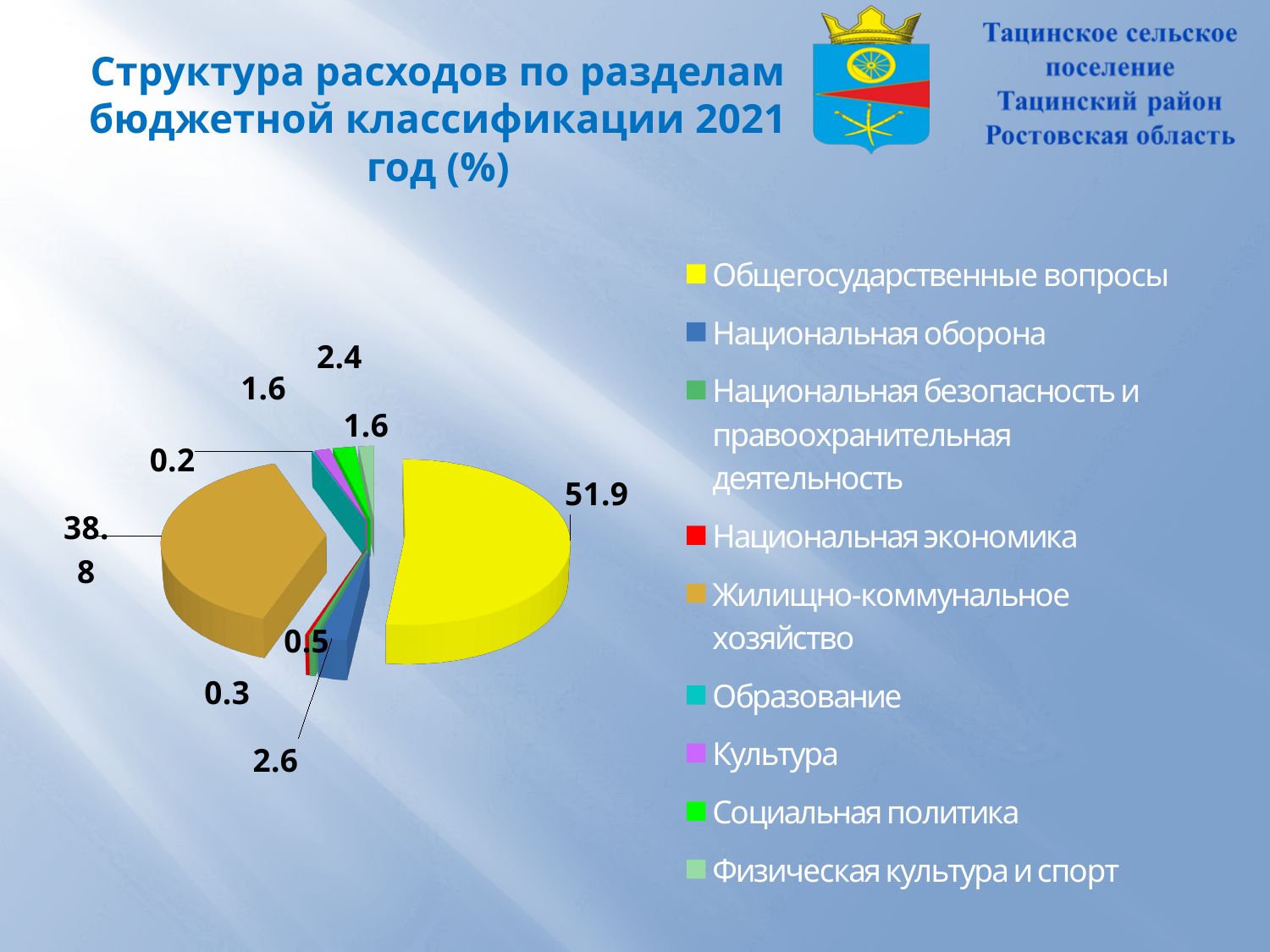
What is the difference between the values for Общегосударственные вопросы and Жилищно-коммунальное хозяйство? 13.1 Which is larger: the share for Общегосударственные вопросы or for Жилищно-коммунальное хозяйство? Общегосударственные вопросы Which is larger: the share for Национальная оборона or for Жилищно-коммунальное хозяйство? Жилищно-коммунальное хозяйство Which category has the largest share of expenditures in the pie chart? Общегосударственные вопросы What is the title of the chart on the slide? Структура расходов по разделам бюджетной классификации 2021 год (%) What is the smallest value labelled on the pie chart? 0.2 How many categories does the legend of the pie chart list? 9 What is the value shown for Национальная оборона? 2.6 What is the value shown for Общегосударственные вопросы? 51.9 What colour is the slice for Общегосударственные вопросы? yellow What is the value shown for Жилищно-коммунальное хозяйство? 38.8 What kind of chart is shown on the slide? pie chart